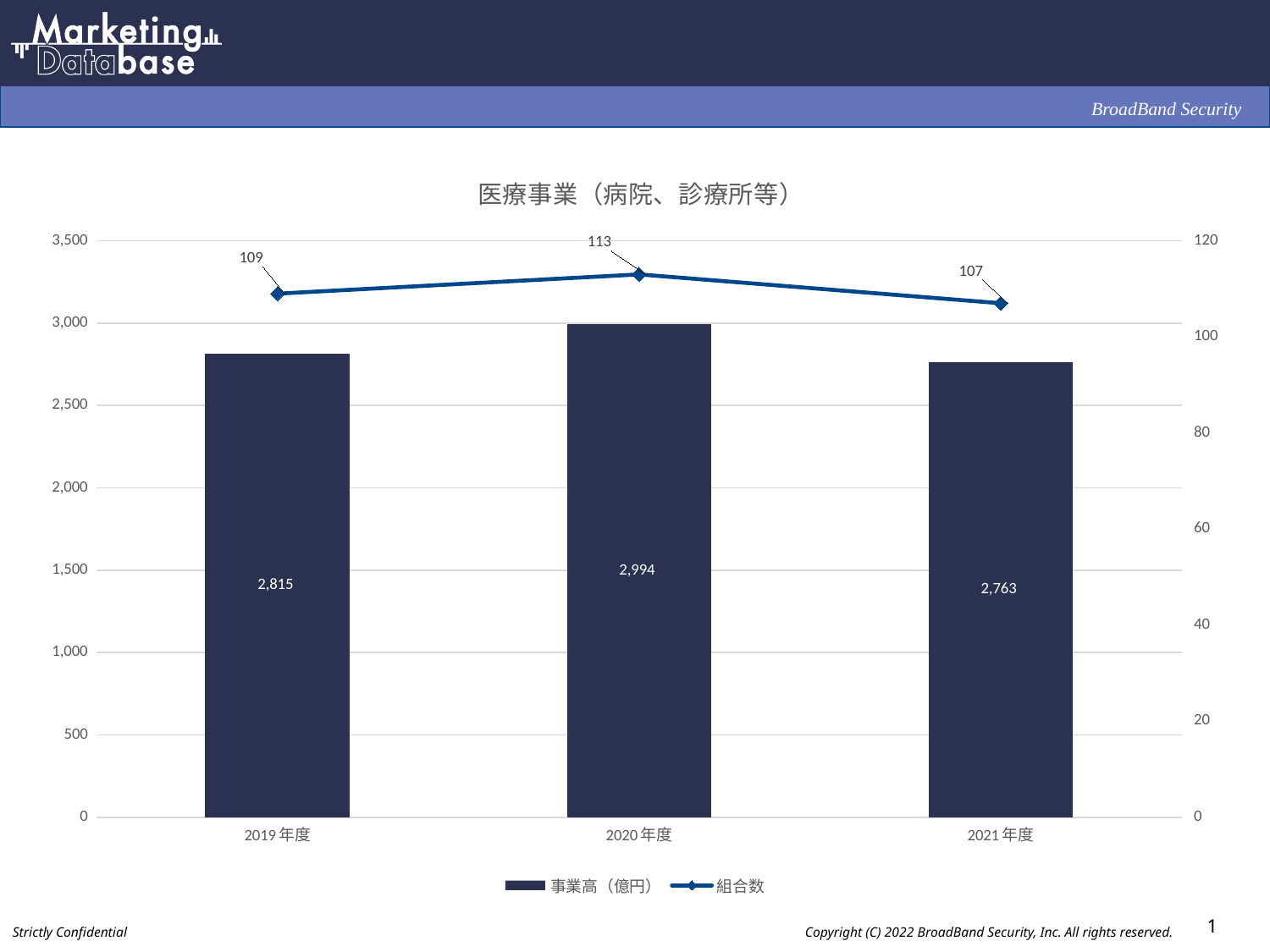
What is the difference in 組合数 between 2020年度 and 2021年度? 6 Which year has the lowest 組合数? 2021年度 What is the title of the chart? 医療事業（病院、診療所等） How many series does the legend list? 2 What is the 事業高（億円） value for 2021年度? 2,763 Which year has the highest 事業高（億円）? 2020年度 What is the 事業高（億円） value for 2020年度? 2,994 What is the difference in 事業高（億円） between 2020年度 and 2019年度? 179 Which is larger, the 事業高（億円） for 2019年度 or for 2021年度? 2019年度 How many years are shown on the x axis? 3 Is the 事業高（億円） value for 2020年度 greater or less than 3,000? less What is the 組合数 value for 2019年度? 109